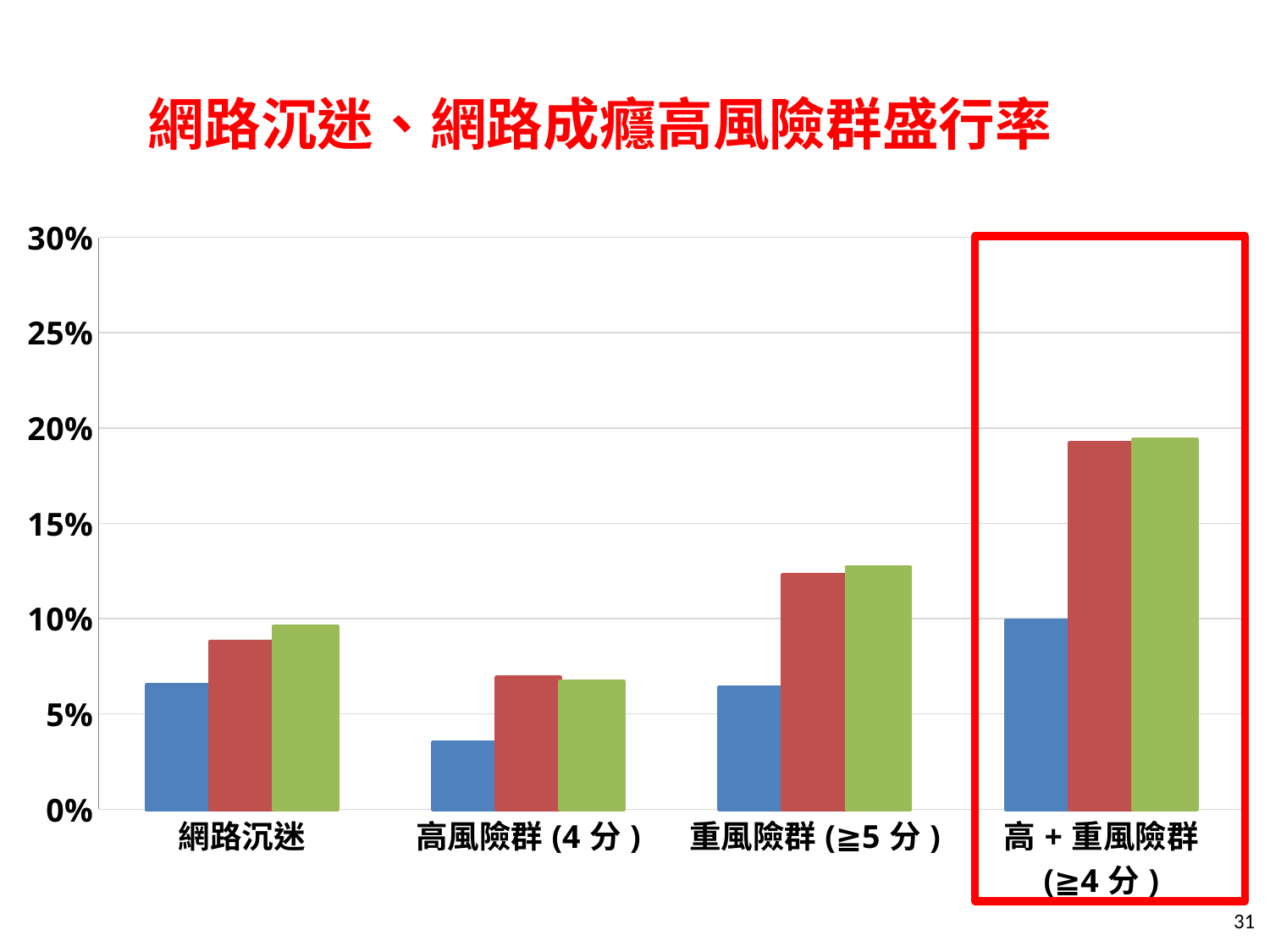
Which category is highlighted with a red box on the chart? 高 + 重風險群 (≧4 分) Is the value of the red bar for 重風險群 (≧5 分) greater or less than 10%? greater What kind of chart is shown on the slide? bar chart Is the value of the blue bar for 高風險群 (4 分) greater or less than 5%? less How many categories are shown on the x axis of the chart? 4 What is the title of the slide's chart? 網路沉迷、網路成癮高風險群盛行率 Is the value of the red bar for 網路沉迷 greater or less than 10%? less For 重風險群 (≧5 分), which is larger: the blue bar or the red bar? the red bar Which category has the tallest green bar? 高 + 重風險群 (≧4 分) How many bars are plotted for each category in the chart? 3 Which category has the shortest blue bar? 高風險群 (4 分)